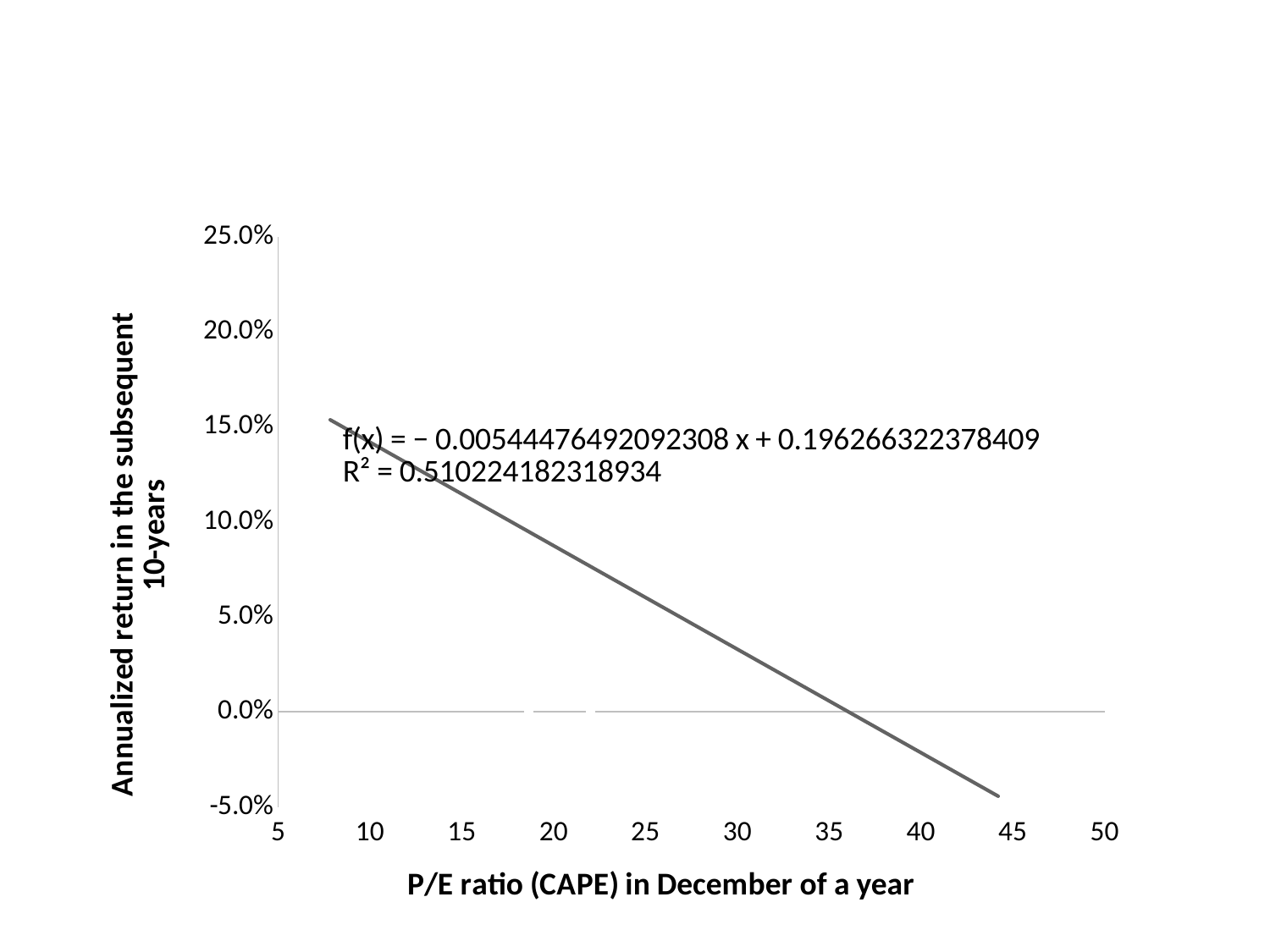
Is the trendline value at a P/E ratio of 20 greater or less than 5.0%? greater Is the trendline value at a P/E ratio of 40 greater or less than 0.0%? less Does the trendline rise or fall as the P/E ratio (CAPE) increases along the x axis? fall Is the trendline value at a P/E ratio of 30 greater or less than 5.0%? less What is the constant (intercept) term in the trendline equation f(x) shown on the chart? 0.196266322378409 What is the title of the y axis? Annualized return in the subsequent 10-years What is the slope coefficient of x in the trendline equation f(x) shown on the chart? − 0.00544476492092308 What R² value is printed on the chart? 0.510224182318934 What is the title of the x axis? P/E ratio (CAPE) in December of a year